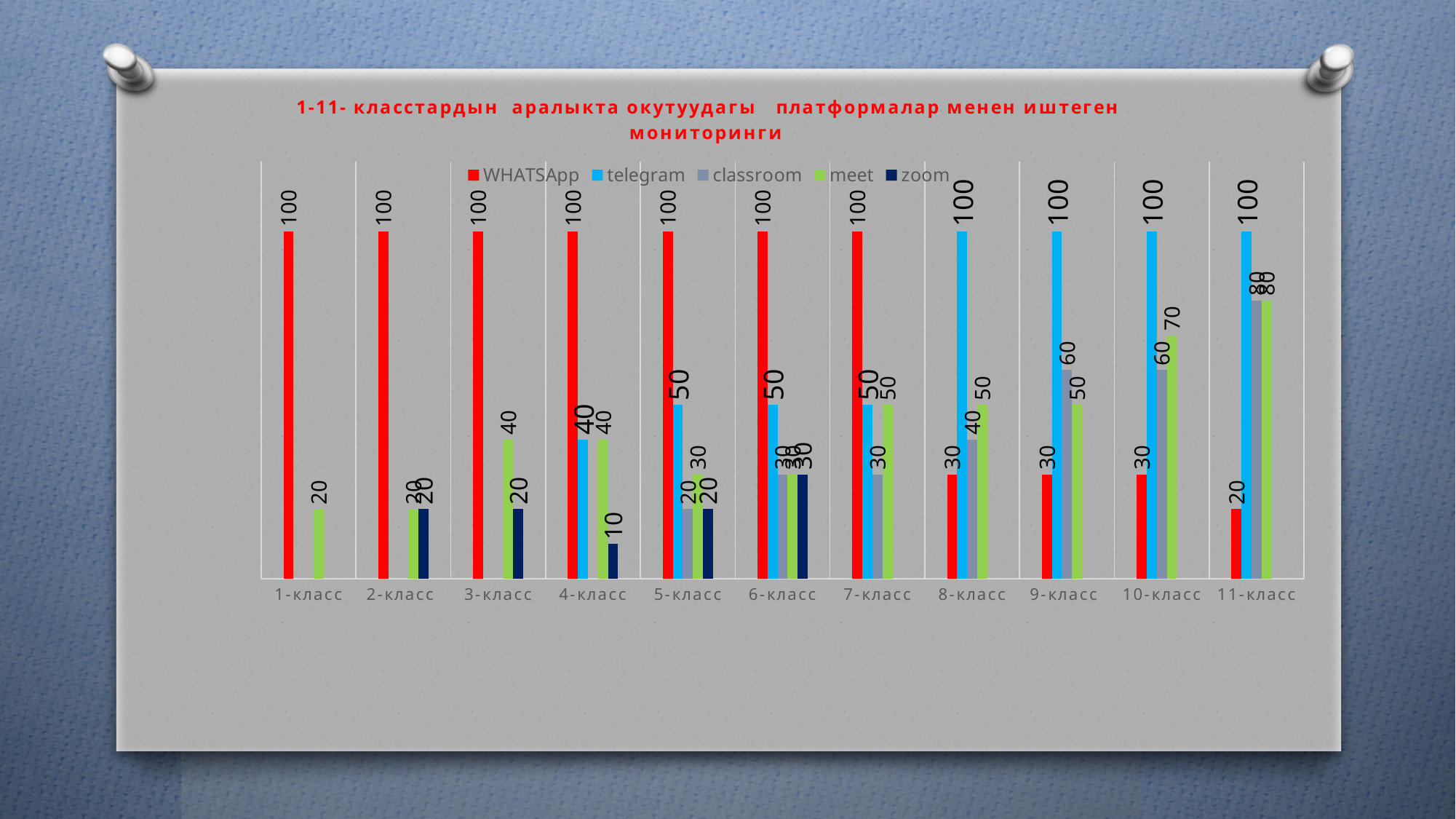
How many class categories are shown on the x axis? 11 What is the value for meet in 1-класс? 20 What is the difference between the WHATSApp value and the telegram value in 8-класс? 70 What is the value for meet in 10-класс? 70 What is the value for zoom in 4-класс? 10 What is the value for telegram in 4-класс? 40 Which series has the highest value in 11-класс? telegram What is the value for classroom in 9-класс? 60 Which series is shown in red in the legend? WHATSApp Which is larger in 7-класс, the classroom value or the meet value? meet What type of chart is shown on the slide? bar chart How many series does the legend list? 5